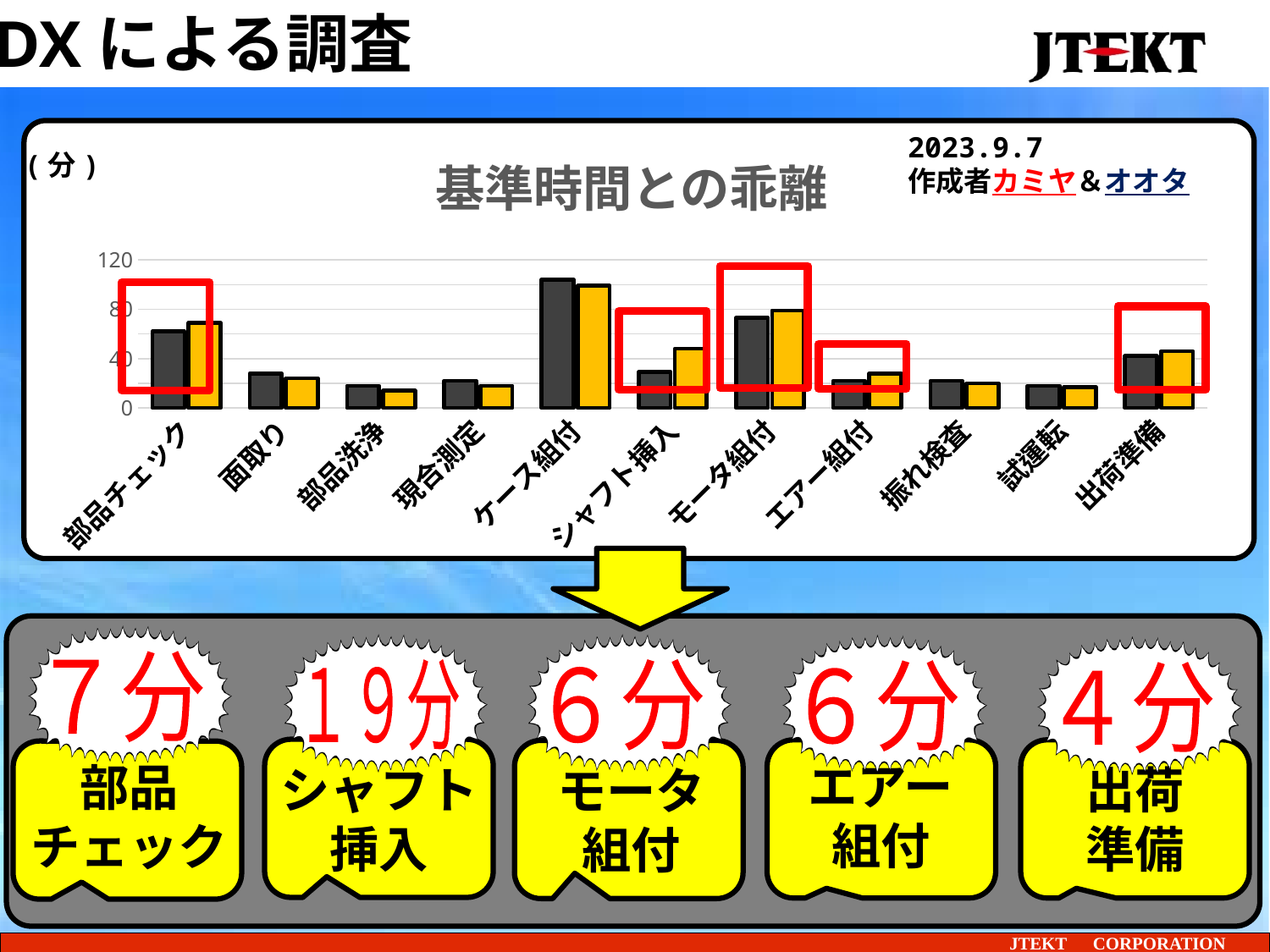
Which category has the tallest bars in the chart? ケース組付 Which has the taller dark gray bar, 部品チェック or 面取り? 部品チェック How many categories are shown on the x axis of the chart? 11 What kind of chart is shown on the slide? bar chart Is the dark gray bar for 振れ検査 greater or less than 40? less Is the orange bar for モータ組付 greater or less than 40? greater What value is printed in the callout for シャフト挿入 below the chart? 19分 What is the title of the chart? 基準時間との乖離 For シャフト挿入, which bar is taller, the dark gray bar or the orange bar? the orange bar How many bars are plotted for each category in the chart? 2 Is the dark gray bar for ケース組付 greater or less than 80? greater